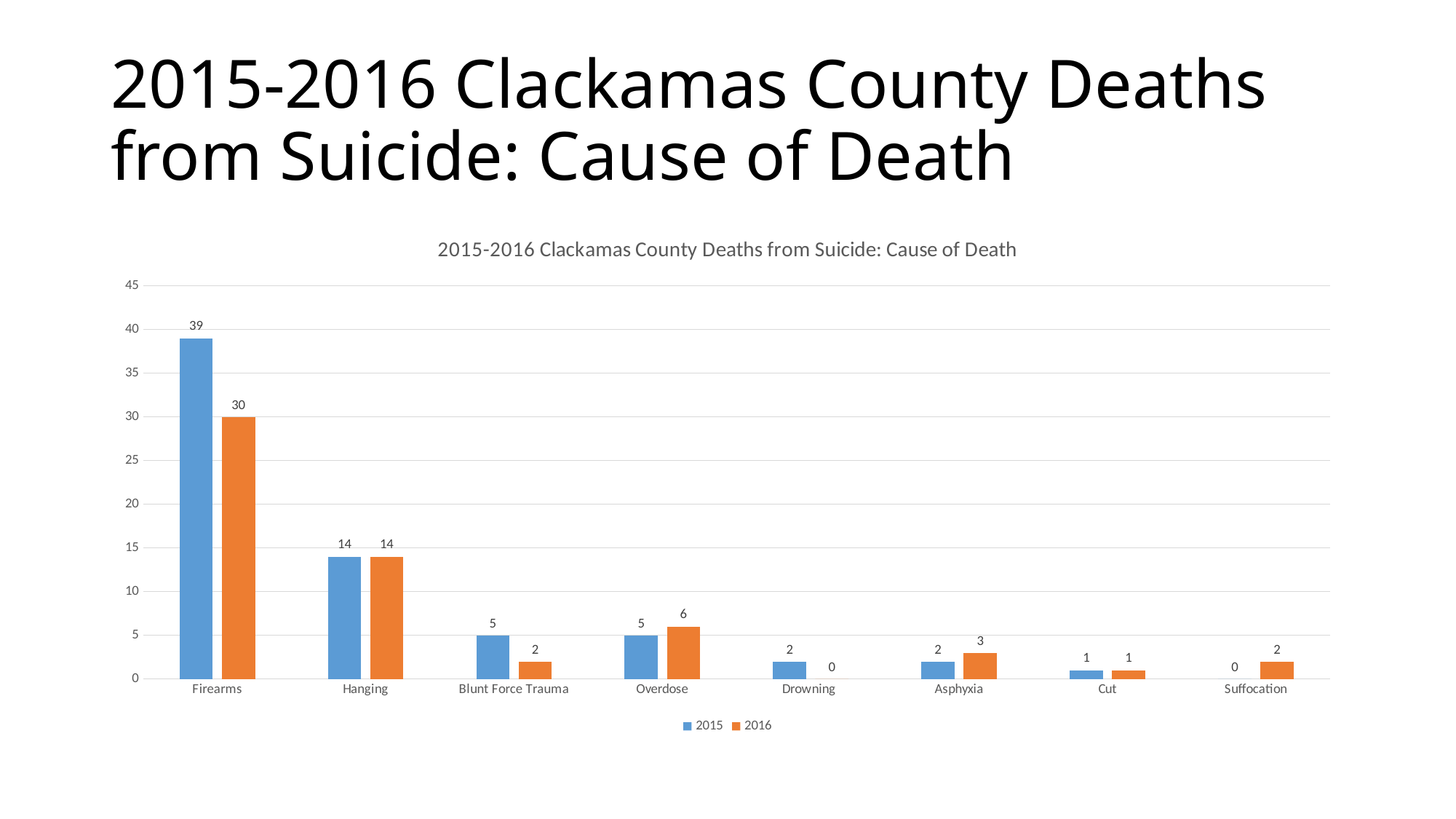
Which is larger for Blunt Force Trauma, the 2015 value or the 2016 value? 2015 How many series does the legend list? 2 What is the value for Overdose in 2016? 6 What kind of chart is shown on the slide? bar chart Which cause of death has the highest value in 2016? Firearms What is the value for Suffocation in 2015? 0 What is the difference between the 2015 and 2016 values for Firearms? 9 Which cause of death has the lowest value in 2015? Suffocation What is the value for Firearms in 2015? 39 Is the value for Hanging in 2015 greater or less than 10? greater Which colour represents the 2016 series? orange How many causes of death are shown on the x axis? 8